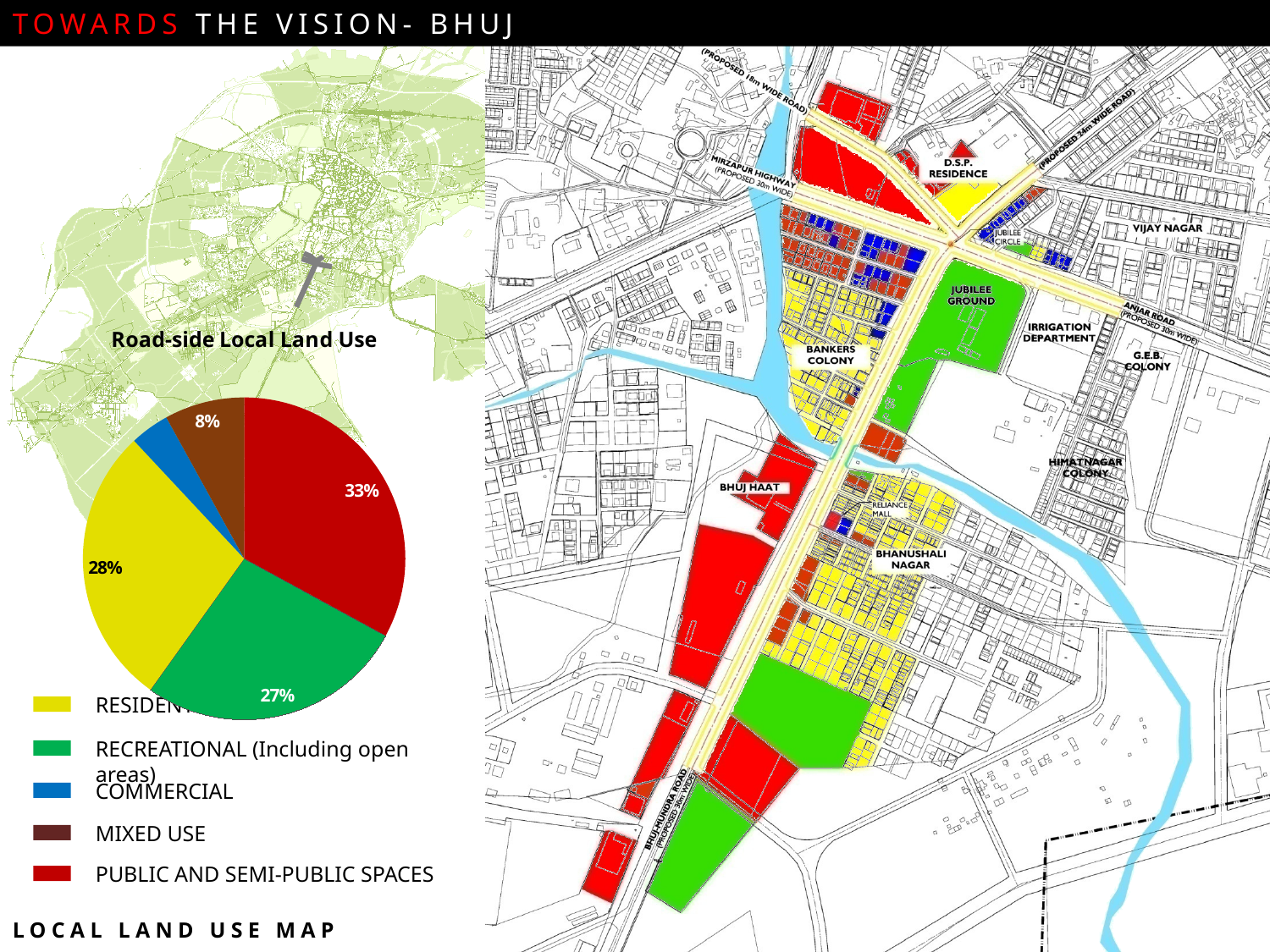
What is the title of the pie chart? Road-side Local Land Use What type of chart is shown on the slide? Pie chart Which land use category has the largest share of the pie? Public and Semi-Public Spaces What percentage of road-side local land use is Recreational (including open areas)? 27% Which land use category has the smallest share of the pie? Commercial Which is larger, the Residential share or the Recreational share? Residential What is the difference in percentage points between Public and Semi-Public Spaces and Residential? 5 percentage points What percentage of road-side local land use is Public and Semi-Public Spaces? 33% What share of the pie does Mixed Use represent? 8% What percentage of road-side local land use is Residential? 28% What colour represents Residential in the pie chart? Yellow How many land use categories does the legend list? 5